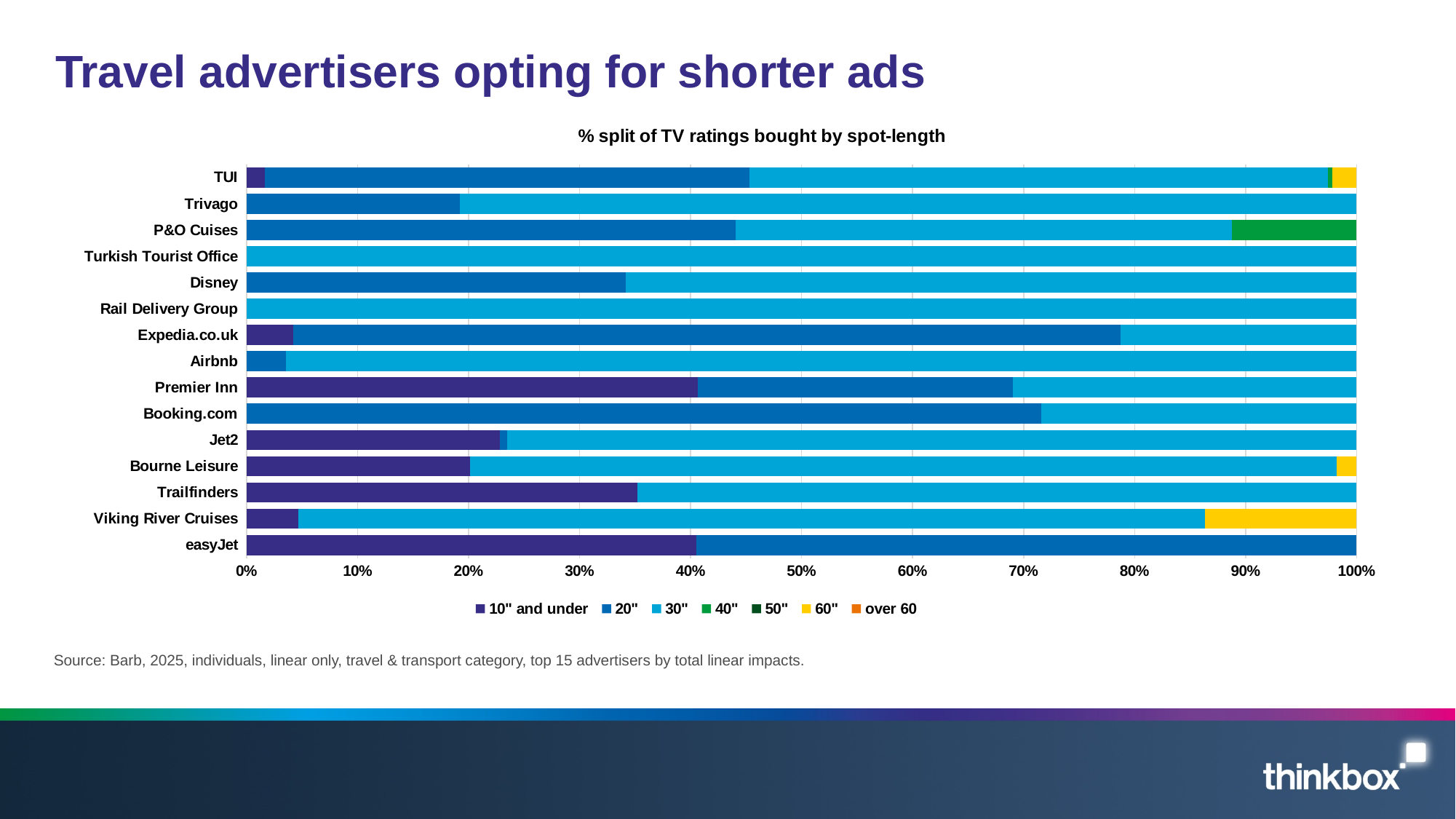
Is the 10" and under share for Trailfinders greater or less than 30%? greater Is the 60" share for Viking River Cruises greater or less than 10%? greater Which has the larger 20" share, Disney or Trivago? Disney Is the 10" and under share for Jet2 greater or less than 20%? greater What is the title of the chart? % split of TV ratings bought by spot-length Which advertiser has the largest share of 60" spots? Viking River Cruises What kind of chart is shown on the slide? Stacked bar chart How many advertisers are listed on the chart? 15 How many series does the legend list? 7 Which has the larger 10" and under share, Trailfinders or Airbnb? Trailfinders